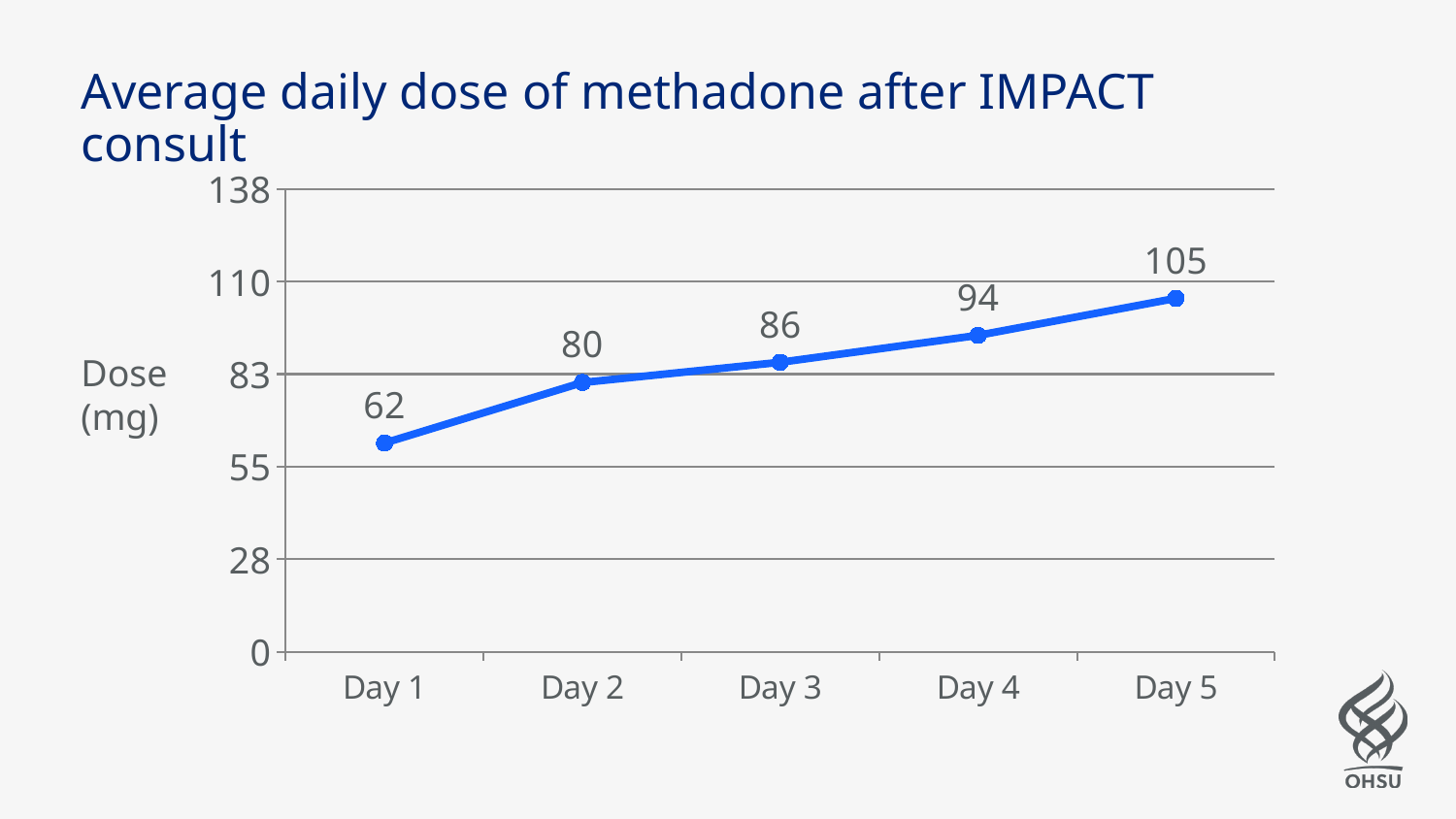
What is the difference between the dose on Day 2 and the dose on Day 1? 18 Which is larger, the dose on Day 4 or the dose on Day 2? Day 4 How many days are plotted on the chart? 5 Which day has the lowest average daily dose? Day 1 What is the average daily dose of methadone on Day 1? 62 Is the value for Day 3 greater or less than 83? greater Do the values rise or fall from Day 1 to Day 5? Rise What is the average daily dose of methadone on Day 3? 86 What is the average daily dose of methadone on Day 5? 105 Which day has the highest average daily dose? Day 5 What is the difference between the dose on Day 5 and the dose on Day 1? 43 What kind of chart is shown on the slide? Line chart